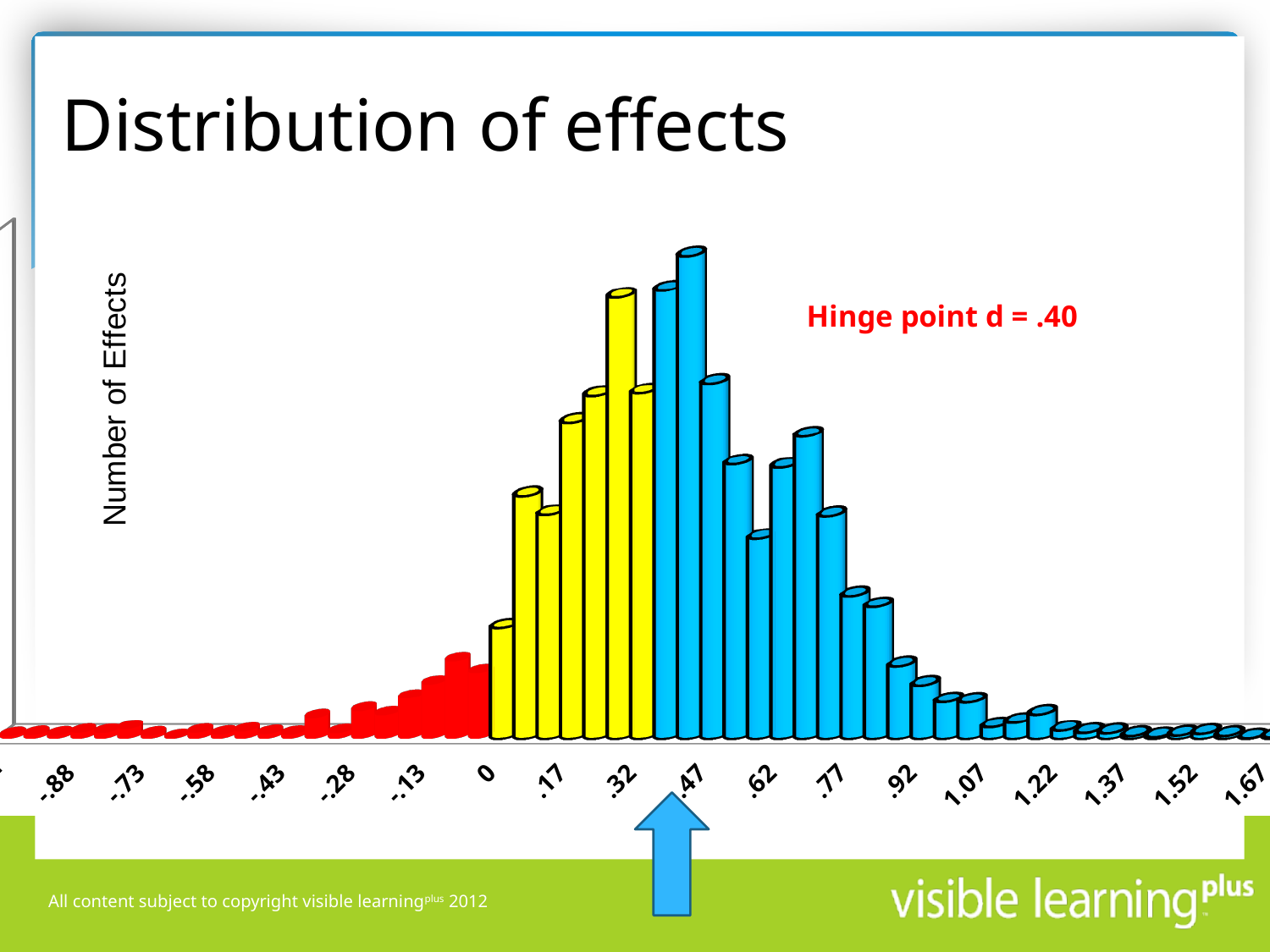
Which is taller, the bar at .32 or the bar at .62? .32 Which is taller, the bar at .77 or the bar at 1.22? .77 What is the hinge point value annotated on the chart? d = .40 What kind of chart is shown on the slide? bar chart Do the bar heights generally rise or fall moving along the x axis from .47 to 1.67? fall What is the label on the vertical axis of the chart? Number of Effects Do the bar heights generally rise or fall moving along the x axis from -.88 to .47? rise Which is taller, the bar at -.13 or the bar at .32? .32